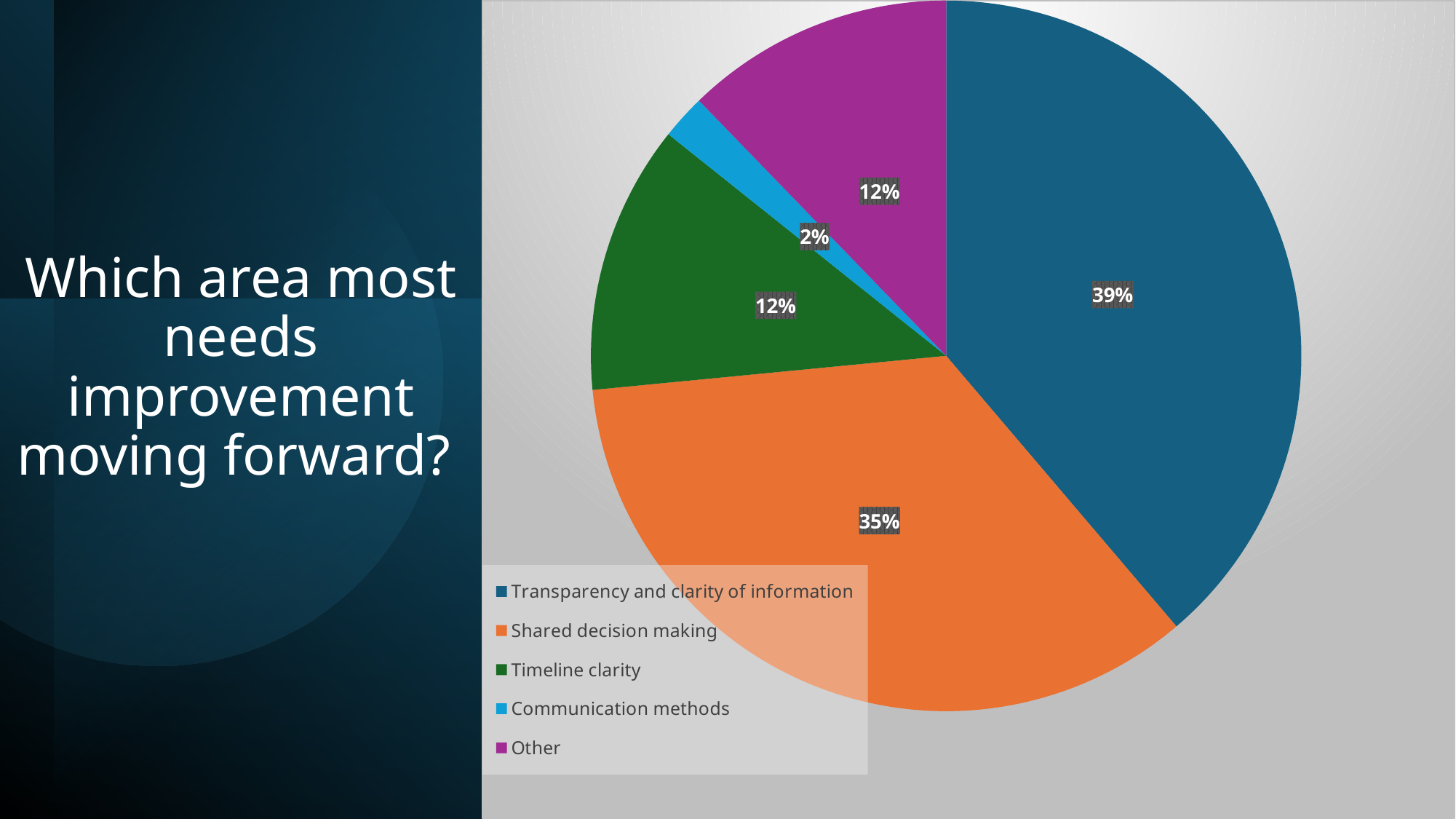
Which category has the smallest slice of the pie? Communication methods How many categories does the pie chart have? 5 What share of the pie does Communication methods have? 2% Which category has the largest slice of the pie? Transparency and clarity of information What share of the pie does Shared decision making have? 35% What share of the pie does Transparency and clarity of information have? 39% What is the difference in percentage points between Transparency and clarity of information and Shared decision making? 4 Which is larger, the slice for Shared decision making or the slice for Timeline clarity? Shared decision making What colour is the slice for Other? purple What kind of chart is shown on the slide? pie chart